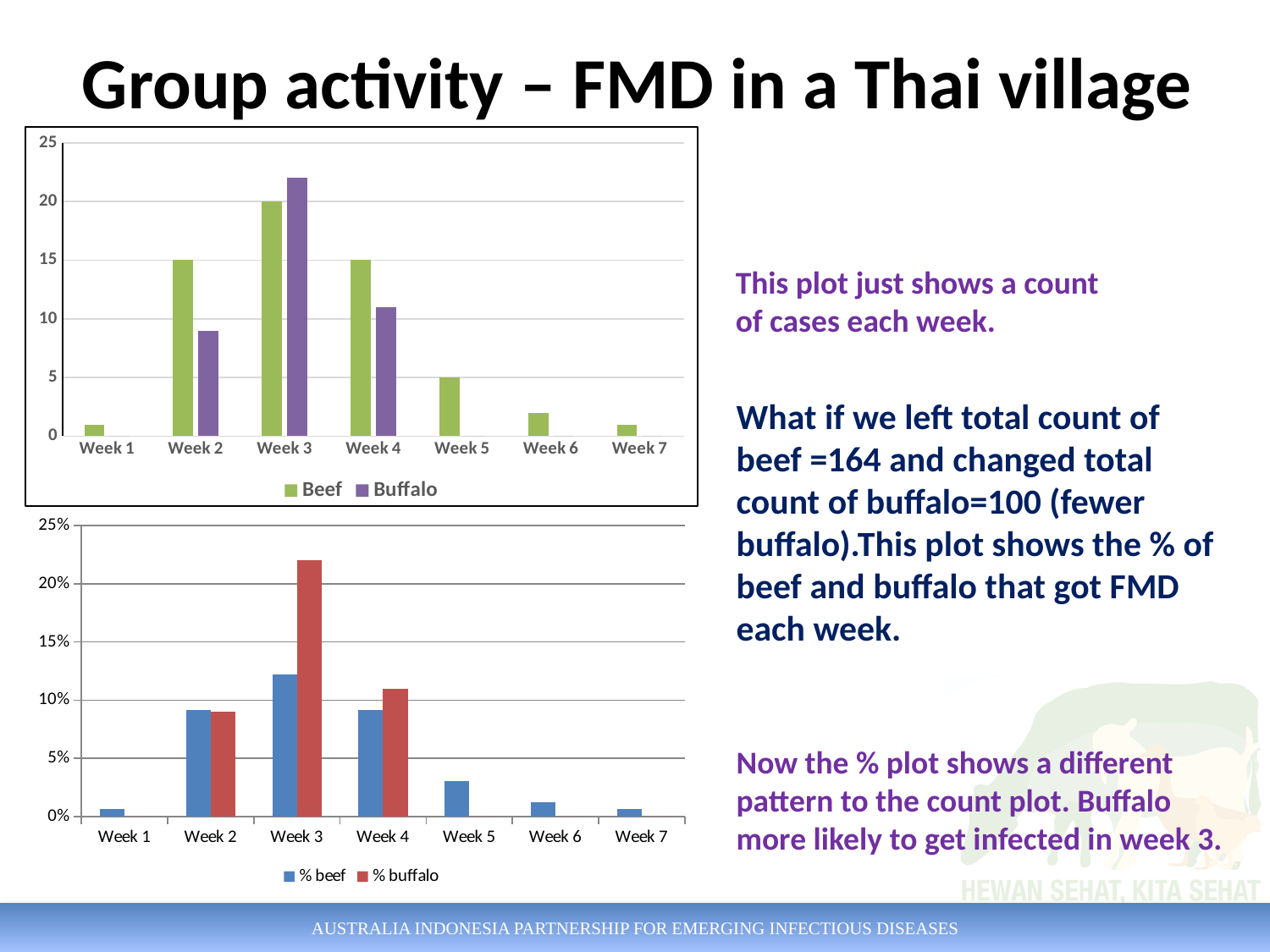
In the bottom chart, which series has the larger value in Week 4, % beef or % buffalo? % buffalo In the top chart, what is the Beef count in Week 5? 5 In the top chart, which series has the larger value in Week 3, Beef or Buffalo? Buffalo In the top chart, in which week is the Buffalo count highest? Week 3 In the top chart, do the Beef values rise or fall from Week 3 to Week 7? fall In the top chart, how many series does the legend list? 2 In the top chart, is the Buffalo value for Week 3 greater or less than 20? greater In the bottom chart, is the % buffalo value for Week 3 greater or less than 20%? greater What kind of chart is the top chart on the slide? bar chart In the top chart, what is the Beef count in Week 3? 20 In the top chart, how many weeks are shown on the x axis? 7 In the bottom chart, what are the two legend entries? % beef and % buffalo